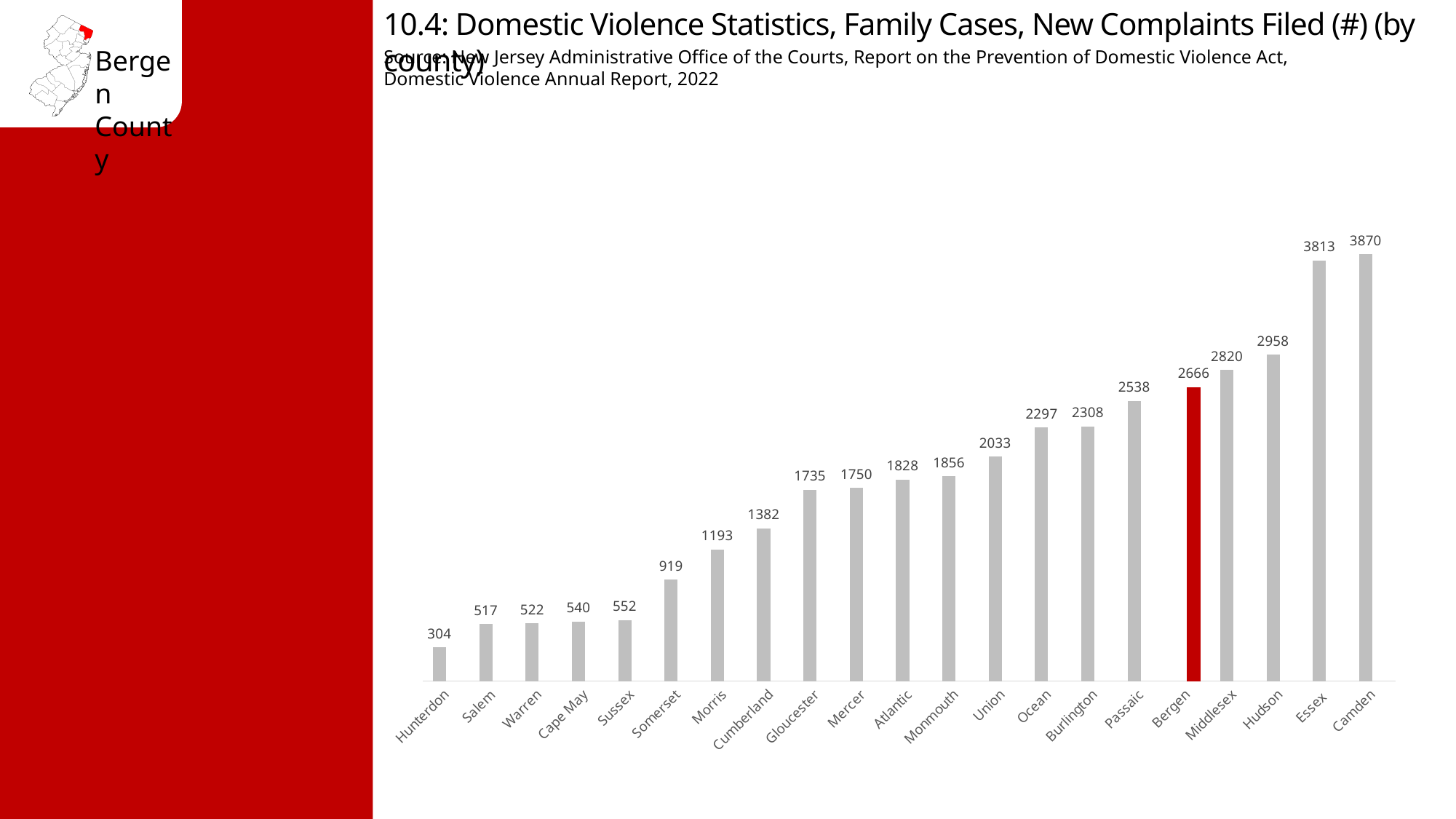
What kind of chart is shown on the slide? Bar chart Which county has the lowest number of new complaints filed? Hunterdon What is the value shown for Hudson? 2958 What is the difference between the values for Camden and Essex? 57 How many counties are shown on the chart? 21 What is the number of new domestic violence family case complaints filed for Bergen? 2666 Which has a larger value, Morris or Cumberland? Cumberland What is the value shown for Somerset? 919 Which county's bar is highlighted in red? Bergen Which county has the highest number of new complaints filed? Camden What is the difference between the values for Bergen and Passaic? 128 Which has a larger value, Middlesex or Bergen? Middlesex